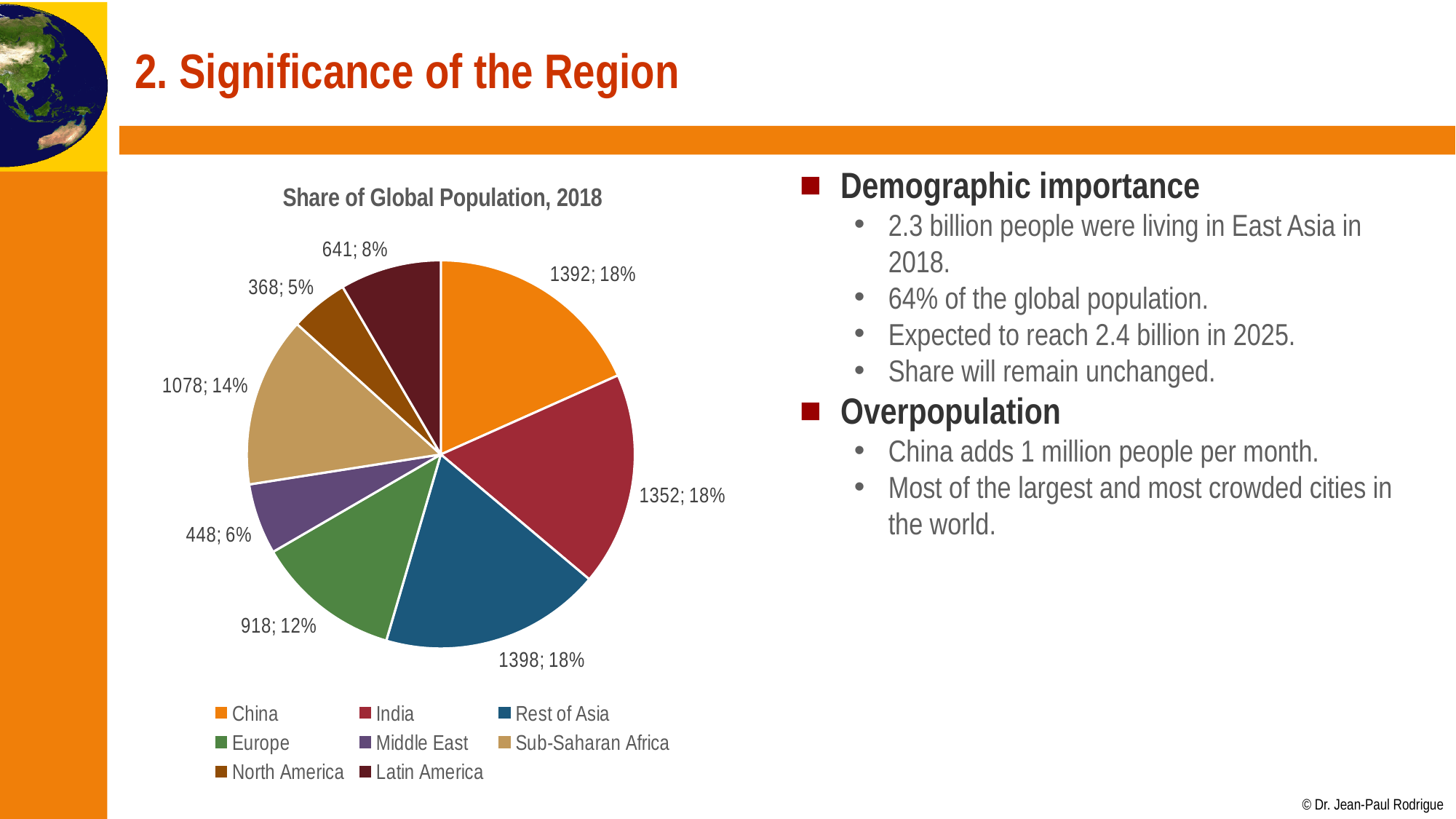
How many categories does the pie chart have? 8 What share of the pie does Latin America represent? 8% Which legend entry is shown in green? Europe What is the population value shown for Europe? 918 What type of chart is shown on the slide? Pie chart What share of the pie does Middle East represent? 6% What is the population value shown for China? 1392 What is the title of the chart? Share of Global Population, 2018 Which category has the smallest slice of the pie? North America Which is larger, the value for Sub-Saharan Africa or the value for Europe? Sub-Saharan Africa What is the difference between the values for Europe and Middle East? 470 What is the population value shown for Sub-Saharan Africa? 1078